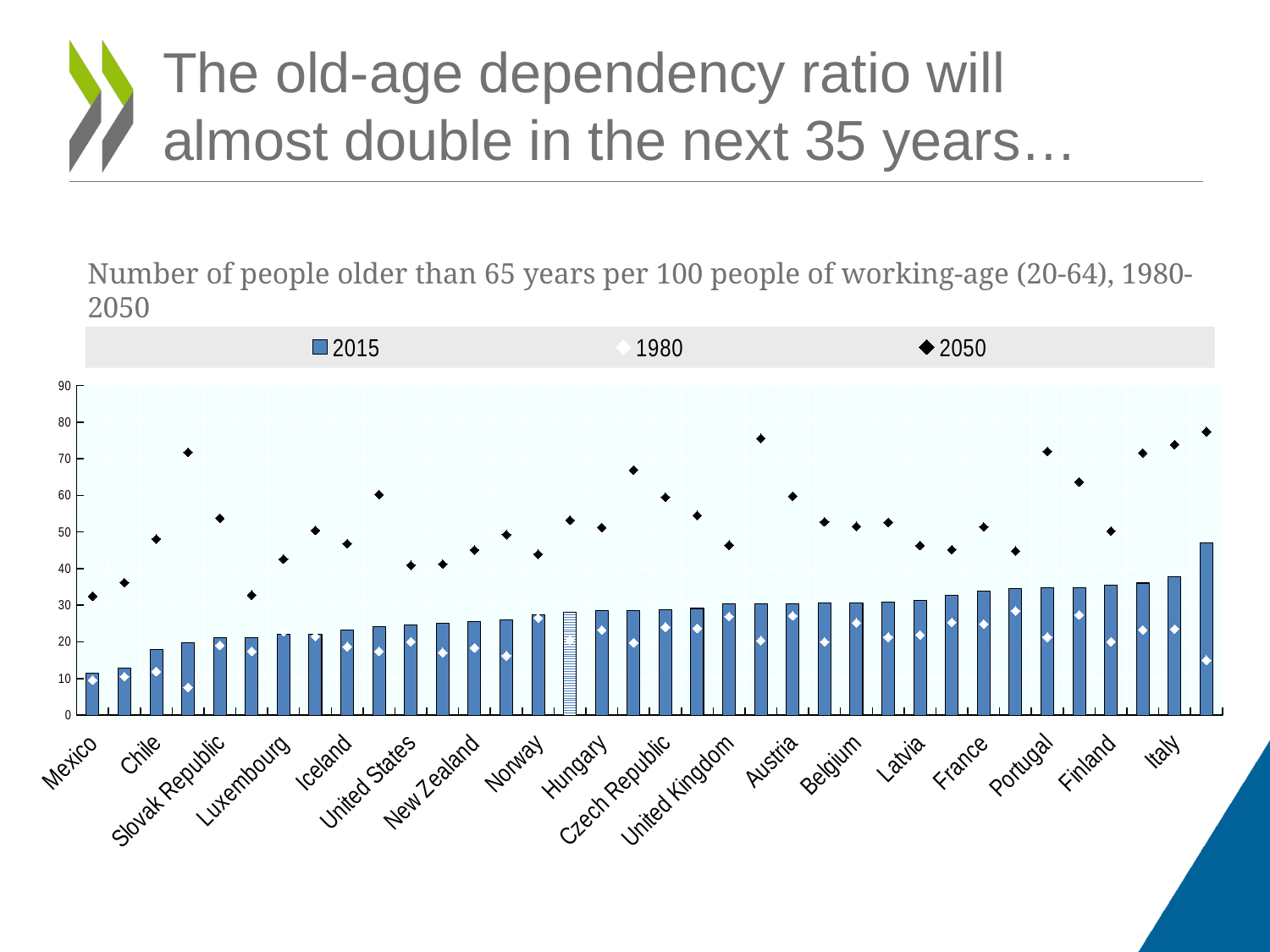
What kind of chart is shown on the slide? combination bar and marker (scatter) chart How many series does the legend list? 3 Is the 2050 value for the Slovak Republic greater or less than 60? less Is the 2015 value for Mexico greater or less than 20? less Do the 2015 bars rise or fall from left to right across the chart? rise Which years are listed in the chart legend? 2015, 1980, 2050 Is the 2050 value for Mexico greater or less than 40? less Which is larger, the 2050 value for Mexico or the 2050 value for Italy? Italy Which country has the lowest 2015 value? Mexico